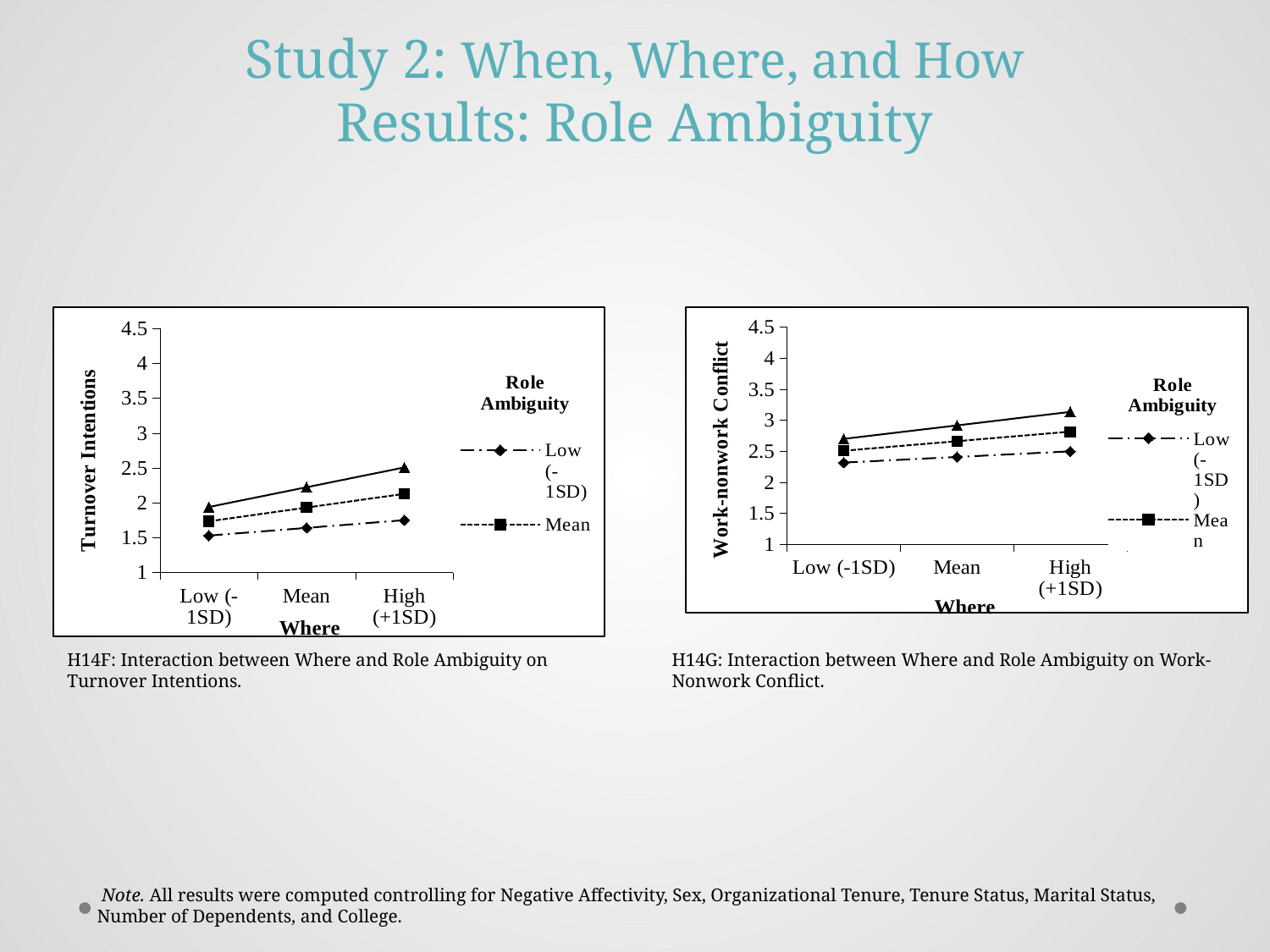
In the left chart (Turnover Intentions), at High (+1SD), which line is higher: Low (-1SD) role ambiguity or Mean role ambiguity? Mean In the right chart (Work-nonwork Conflict), what kind of chart is shown? line chart In the right chart (Work-nonwork Conflict), how many categories are on the x axis? 3 In the right chart (Work-nonwork Conflict), is the value of the Mean role ambiguity line at High (+1SD) greater or less than 2.5? greater In the left chart (Turnover Intentions), does the Mean role ambiguity line rise or fall from Low (-1SD) to High (+1SD)? rise What is the y-axis title of the left chart? Turnover Intentions In the left chart (Turnover Intentions), how many categories are on the x axis? 3 In the right chart (Work-nonwork Conflict), is the value of the Low (-1SD) role ambiguity line at Low (-1SD) greater or less than 2.5? less In the right chart (Work-nonwork Conflict), does the Low (-1SD) role ambiguity line rise or fall from Low (-1SD) to High (+1SD)? rise What is the x-axis title of the right chart? Where In the left chart (Turnover Intentions), what kind of chart is shown? line chart In the left chart (Turnover Intentions), is the value of the Low (-1SD) role ambiguity line at High (+1SD) greater or less than 2? less